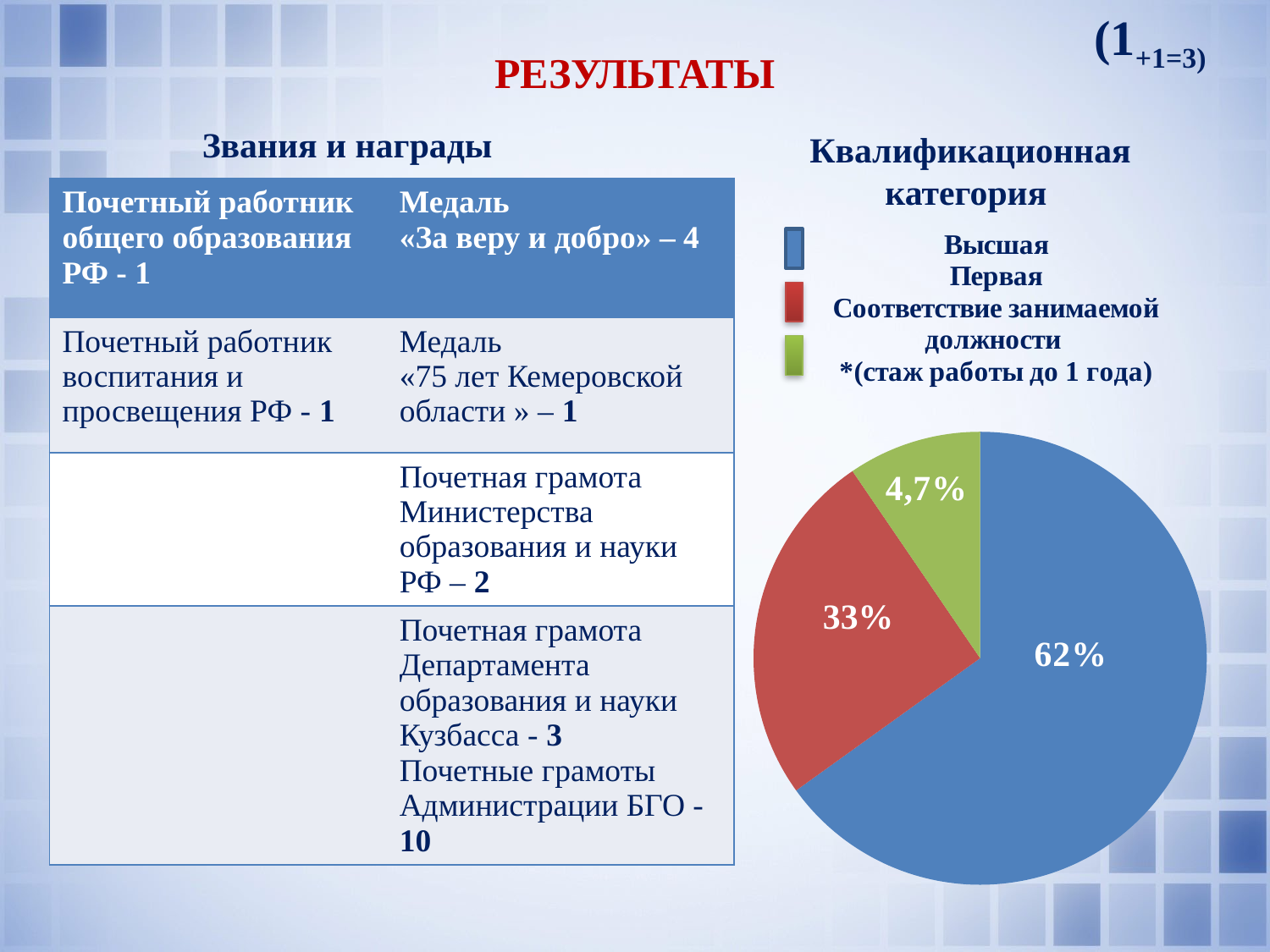
Which category has the largest slice in the pie chart? Высшая How many slices does the pie chart have? 3 How many entries does the legend of the pie chart list? 3 What share of the pie chart does the «Первая» category have? 33% Which is larger in the pie chart: «Высшая» or «Первая»? Высшая What colour is the «Первая» slice in the pie chart? red What is the difference in percentage points between the «Высшая» and «Первая» slices? 29 What share of the pie chart does «Соответствие занимаемой должности» have? 4,7% What is the title of the pie chart? Квалификационная категория What kind of chart is shown under the heading «Квалификационная категория»? pie chart Which category has the smallest slice in the pie chart? Соответствие занимаемой должности What share of the pie chart does the «Высшая» category have? 62%